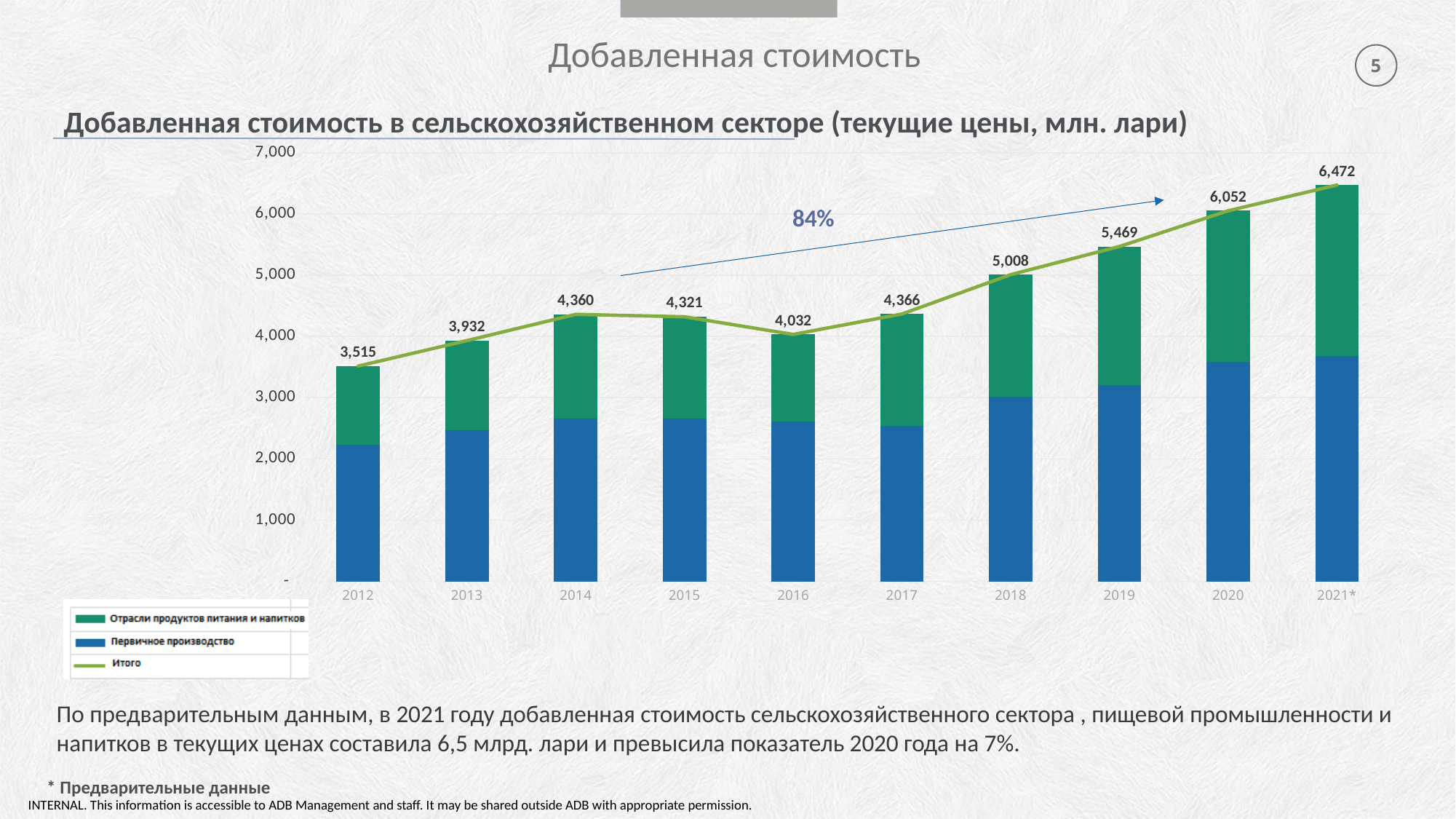
Which year has a larger total value, 2014 or 2017? 2017 How many series does the legend list? 3 How many years are shown on the x axis? 10 What is the total value (Итого) for 2021*? 6,472 Is the value for Первичное производство in 2020 greater or less than 3,000? greater What is the total value (Итого) for 2012? 3,515 What is the difference between the total values for 2021* and 2020? 420 What kind of chart is shown on the slide? Stacked bar chart with a line Which year has the lowest total value? 2012 What percentage growth is annotated by the arrow on the chart? 84% Which year has the highest total value? 2021* What is the total value (Итого) for 2016? 4,032